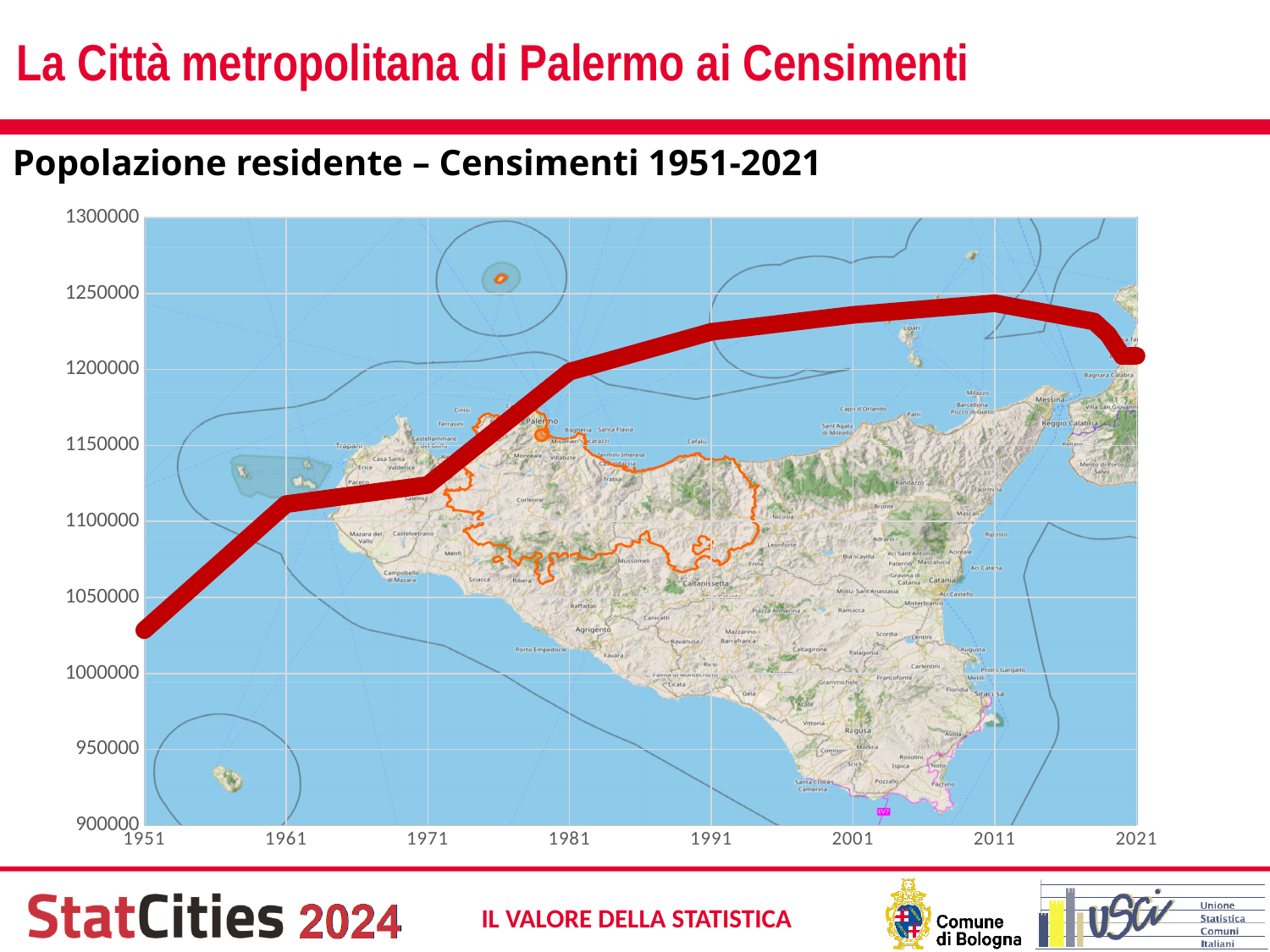
Which census year has the larger resident population, 2011 or 2021? 2011 How many census years are plotted on the x axis of the chart? 8 What is the title of the chart on the slide? Popolazione residente – Censimenti 1951-2021 In which census year is the resident population lowest? 1951 Does the resident population rise or fall between 1951 and 2011? rise Which census year has the larger resident population, 1951 or 2021? 2021 Is the value for 1981 greater or less than 1150000? greater Is the value for 2011 greater or less than 1200000? greater Is the value for 2021 greater or less than 1250000? less In which census year is the resident population highest? 2011 What kind of chart is shown on the slide? line chart